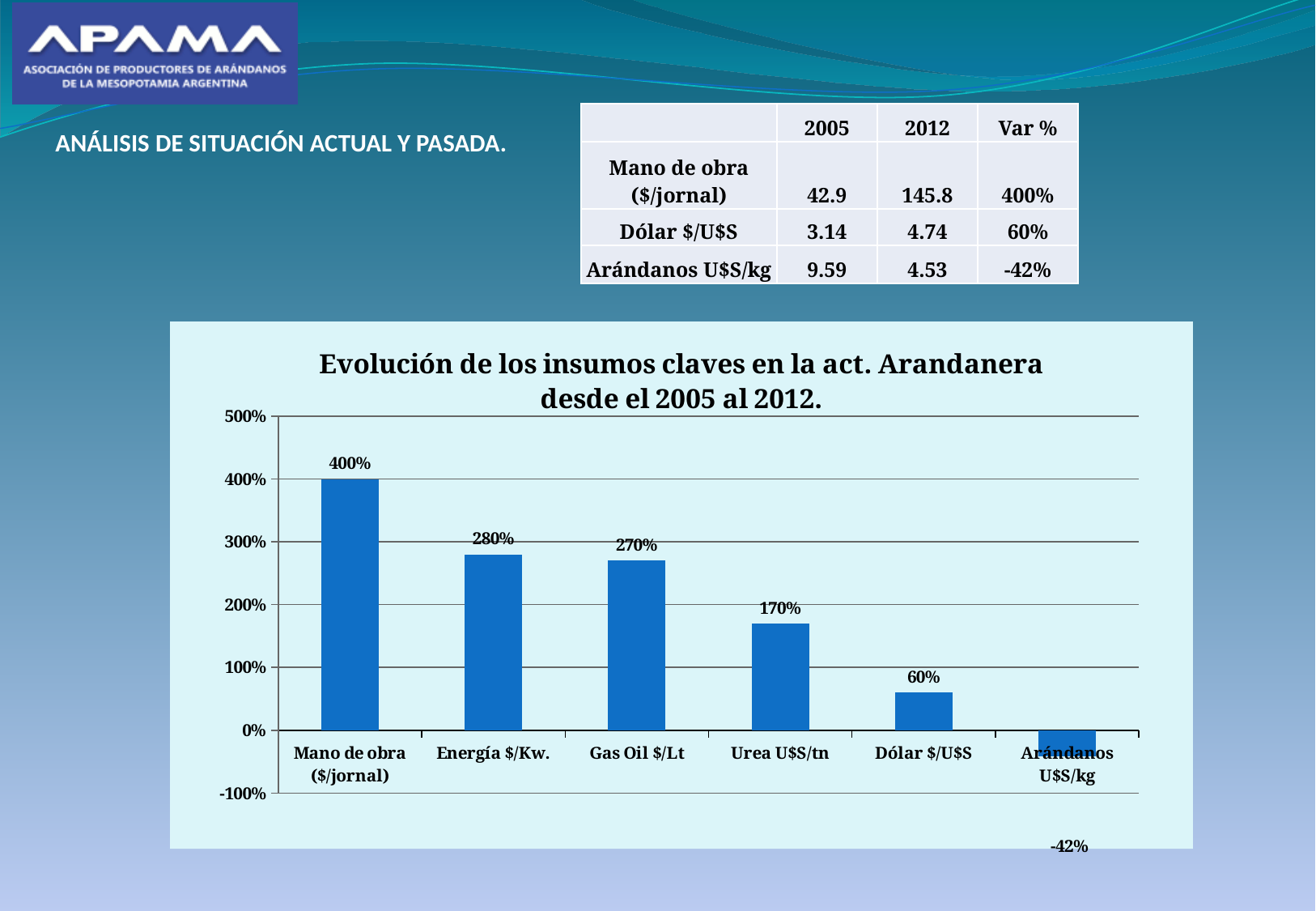
What kind of chart is shown on the slide? Bar chart What is the title of the chart? Evolución de los insumos claves en la act. Arandanera desde el 2005 al 2012. Which category has the lowest value in the chart? Arándanos U$S/kg What is the value for Gas Oil $/Lt in the chart? 270% What is the value for Energía $/Kw. in the chart? 280% Which is larger, the value for Urea U$S/tn or the value for Dólar $/U$S? Urea U$S/tn What is the value for Mano de obra ($/jornal) in the chart? 400% Which category has the highest value in the chart? Mano de obra ($/jornal) How many categories are shown in the chart? 6 What is the value for Arándanos U$S/kg in the chart? -42% What is the difference between the values for Mano de obra ($/jornal) and Dólar $/U$S? 340% What is the value for Urea U$S/tn in the chart? 170%